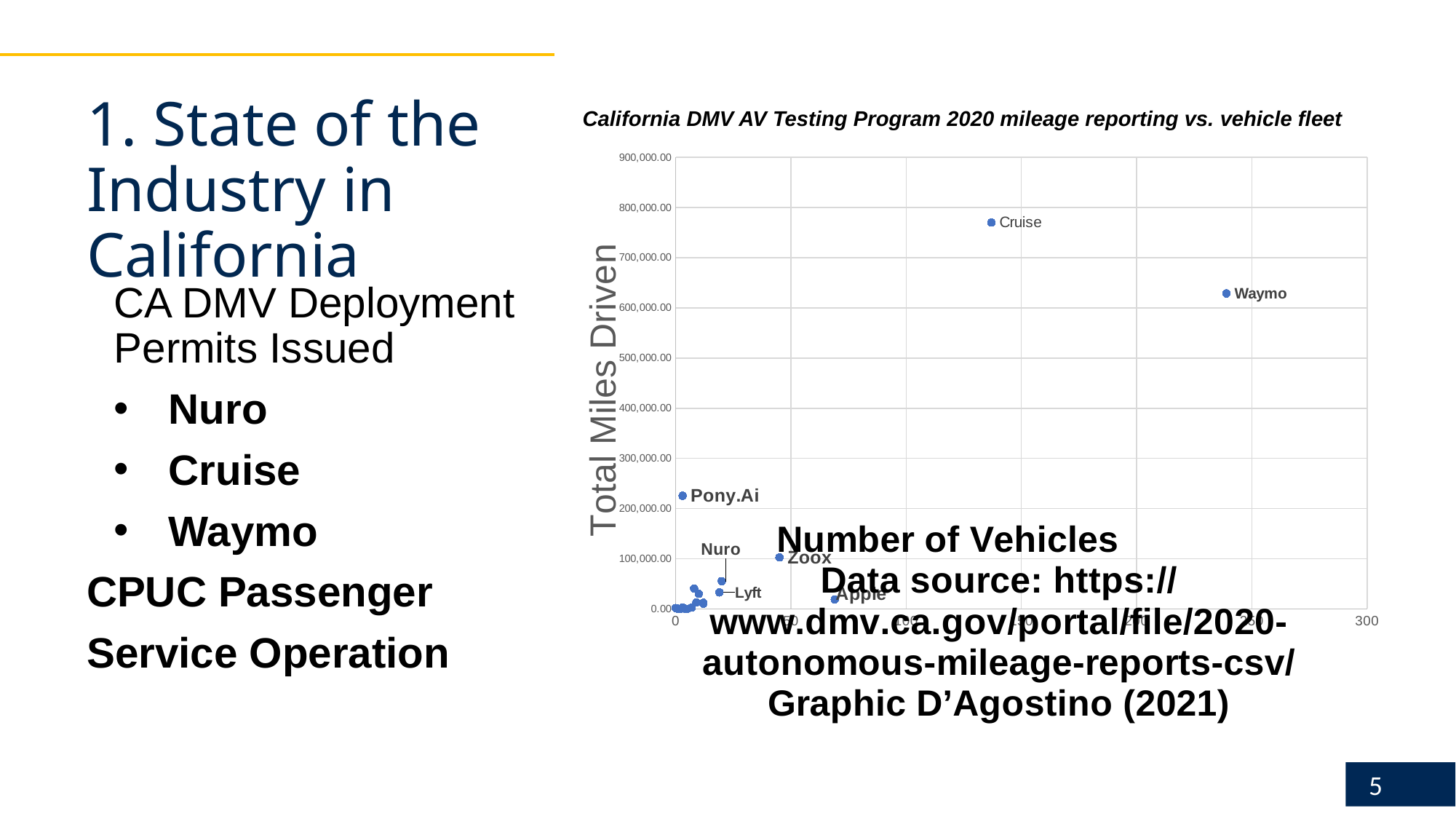
Is the total miles driven for Pony.Ai greater or less than 200,000.00? greater Which has more total miles driven, Cruise or Waymo? Cruise Is the total miles driven for Zoox greater or less than 200,000.00? less What is the label on the vertical axis of the chart? Total Miles Driven What kind of chart is shown on the slide? scatter chart Is the total miles driven for Waymo greater or less than 600,000.00? greater Which labeled company has the highest total miles driven? Cruise What is the title of the chart? California DMV AV Testing Program 2020 mileage reporting vs. vehicle fleet Which labeled company has the largest number of vehicles? Waymo Which has more vehicles, Waymo or Cruise? Waymo How many companies are labeled by name on the chart? 7